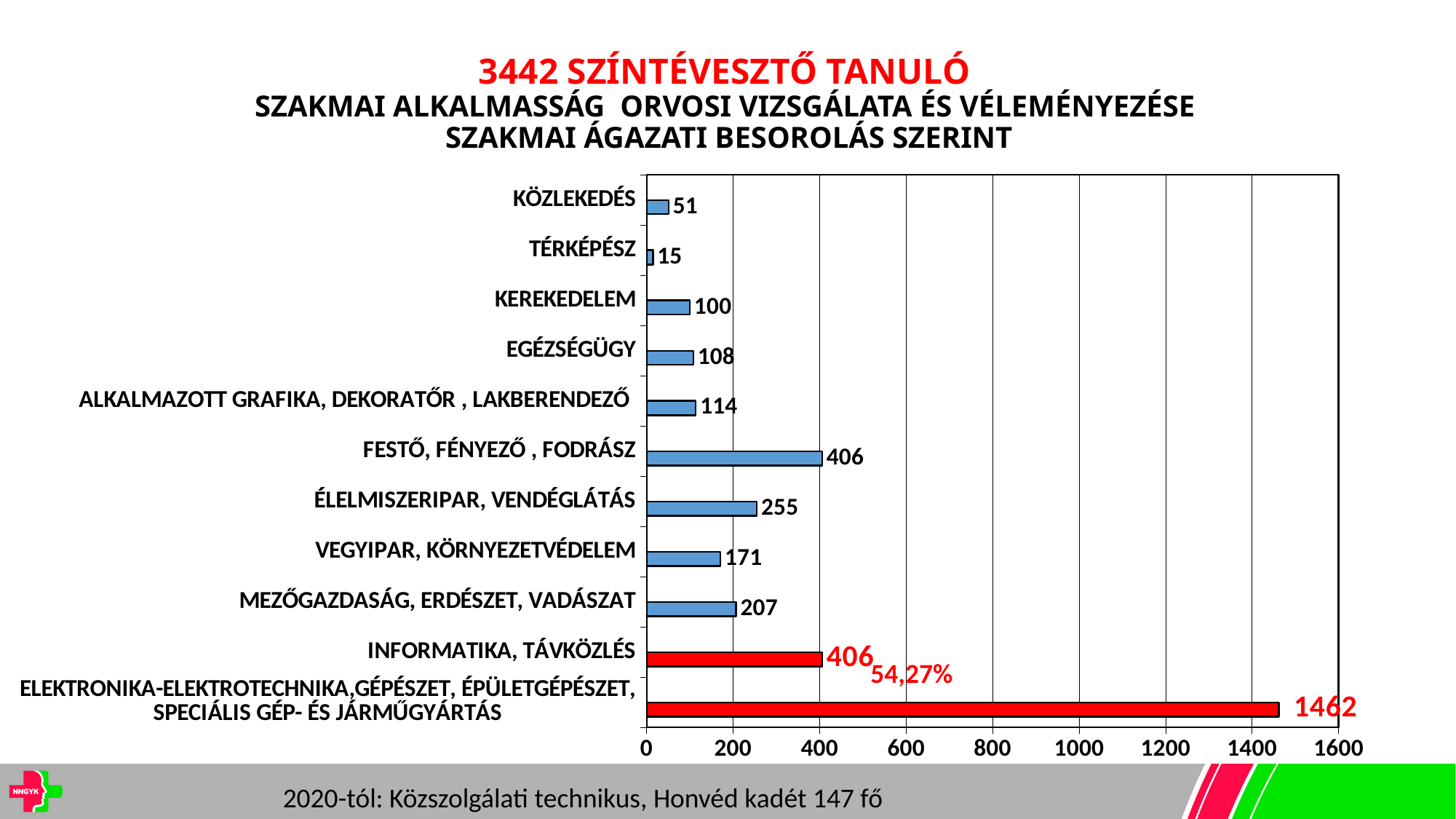
What is the difference between the values for MEZŐGAZDASÁG, ERDÉSZET, VADÁSZAT and VEGYIPAR, KÖRNYEZETVÉDELEM? 36 What kind of chart is shown on the slide? bar chart Which category has the highest value? ELEKTRONIKA-ELEKTROTECHNIKA,GÉPÉSZET, ÉPÜLETGÉPÉSZET, SPECIÁLIS GÉP- ÉS JÁRMŰGYÁRTÁS How many categories are plotted in the chart? 11 Is the value for FESTŐ, FÉNYEZŐ , FODRÁSZ greater or less than 200? greater Which is larger, the value for EGÉZSÉGÜGY or the value for KEREKEDELEM? EGÉZSÉGÜGY What is the value for INFORMATIKA, TÁVKÖZLÉS? 406 Which category has the lowest value? TÉRKÉPÉSZ What is the highest value shown on the x axis? 1600 What is the value for ÉLELMISZERIPAR, VENDÉGLÁTÁS? 255 What is the value for KÖZLEKEDÉS? 51 What percentage label is printed next to the INFORMATIKA, TÁVKÖZLÉS bar? 54,27%